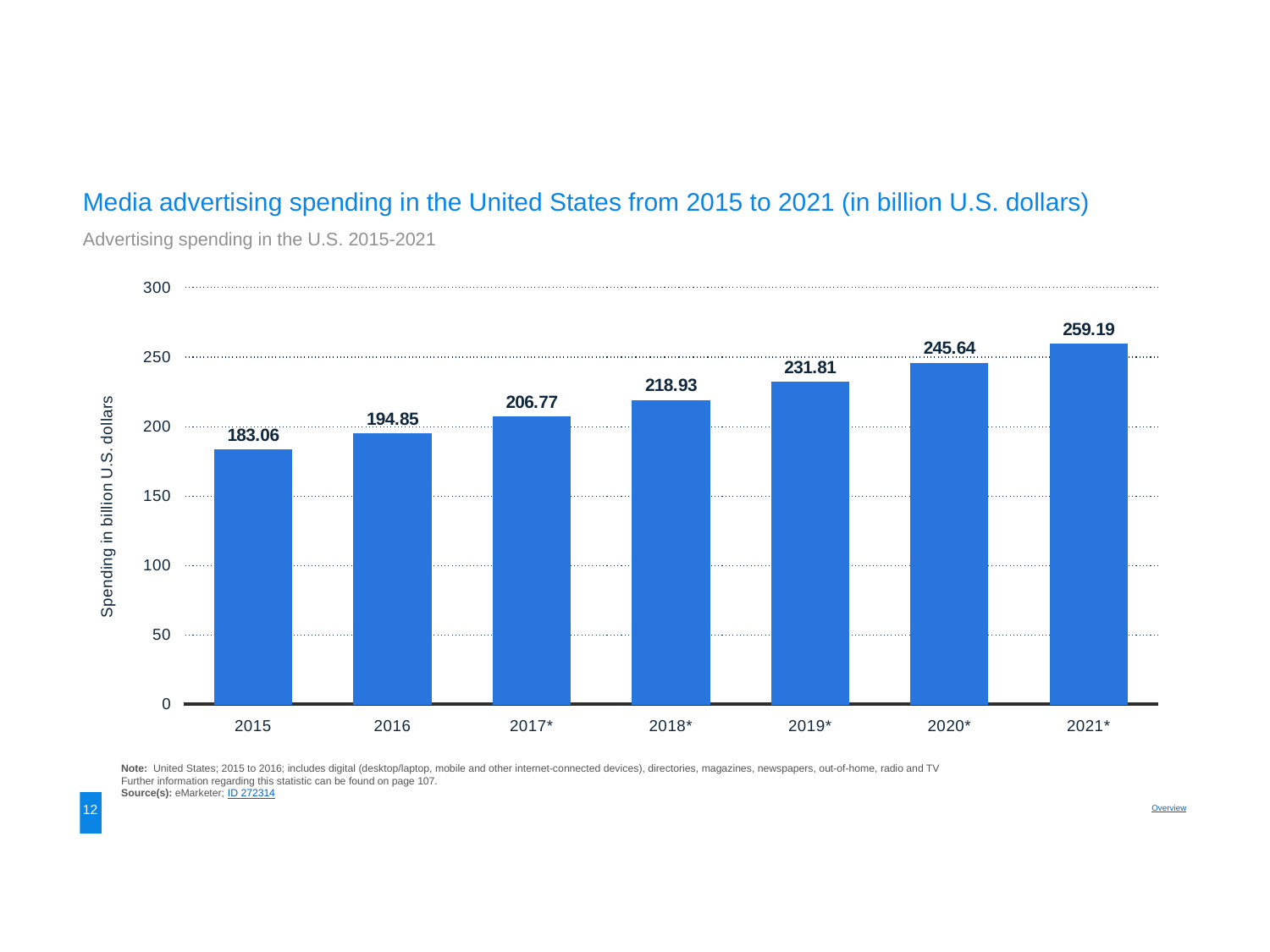
Is the value for 2016 greater or less than 200? less What is the difference between the values for 2017* and 2016? 11.92 What is the value shown for 2020*? 245.64 Which year has the lowest advertising spending? 2015 Do the values rise or fall from 2015 to 2021*? rise Which is larger, the value for 2019* or the value for 2018*? 2019* What is the media advertising spending value for 2015? 183.06 How many years are shown on the x axis? 7 What kind of chart is shown on the slide? bar chart Which year has the highest advertising spending? 2021* What is the value shown for 2018*? 218.93 What is the difference between the values for 2021* and 2015? 76.13